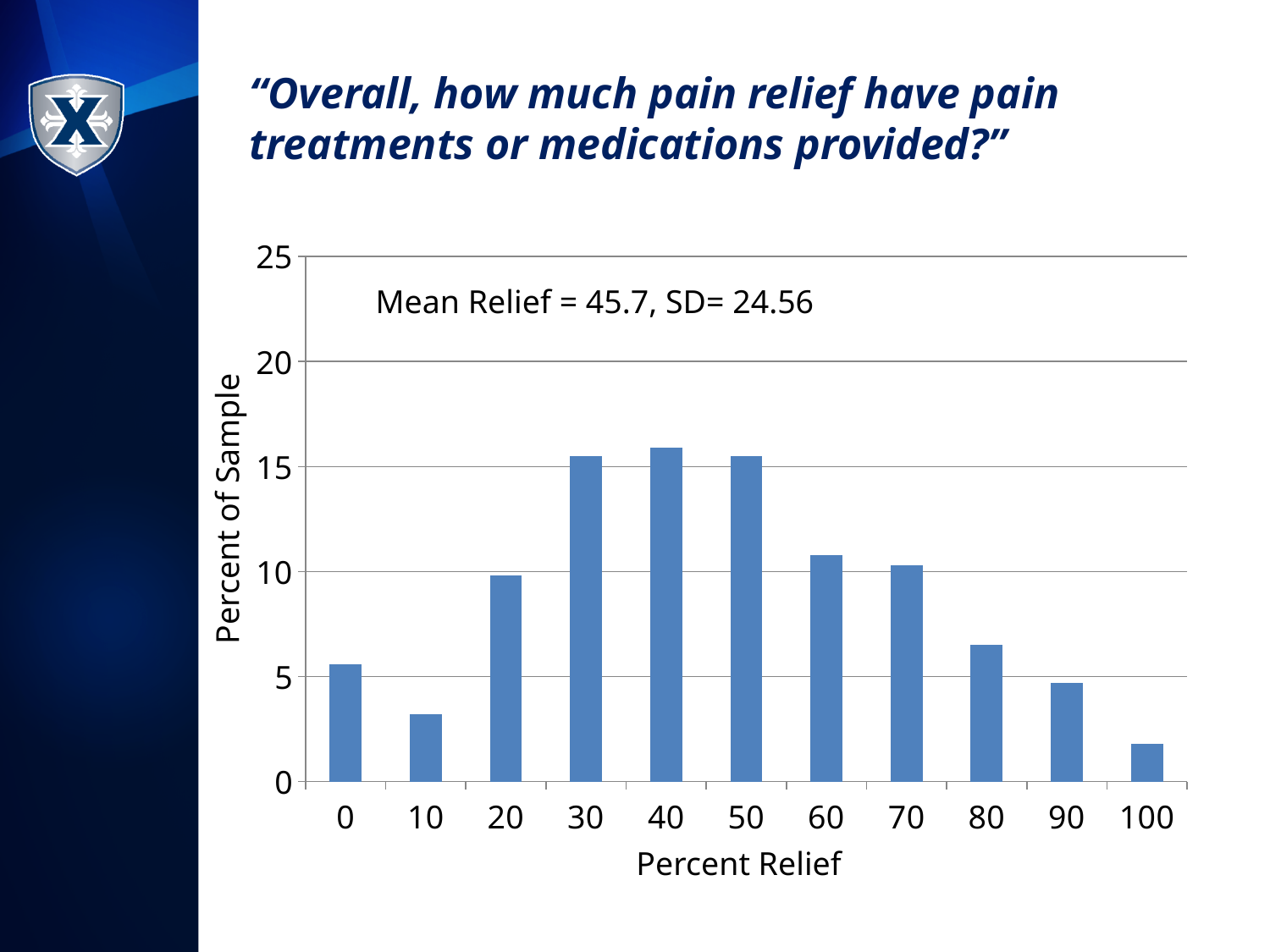
Is the Percent of Sample for the 60 Percent Relief category greater or less than 10? greater Which has a higher Percent of Sample, the 20 or the 10 Percent Relief category? 20 Which Percent Relief category has the lowest Percent of Sample? 100 Is the Percent of Sample for the 80 Percent Relief category greater or less than 5? greater What kind of chart is shown on the slide? bar chart What mean relief value is stated on the chart? 45.7 Is the Percent of Sample for the 100 Percent Relief category greater or less than 5? less Which has a higher Percent of Sample, the 60 or the 80 Percent Relief category? 60 How many Percent Relief categories are plotted on the x axis? 11 Do the bars rise or fall as Percent Relief goes from 50 to 100? fall